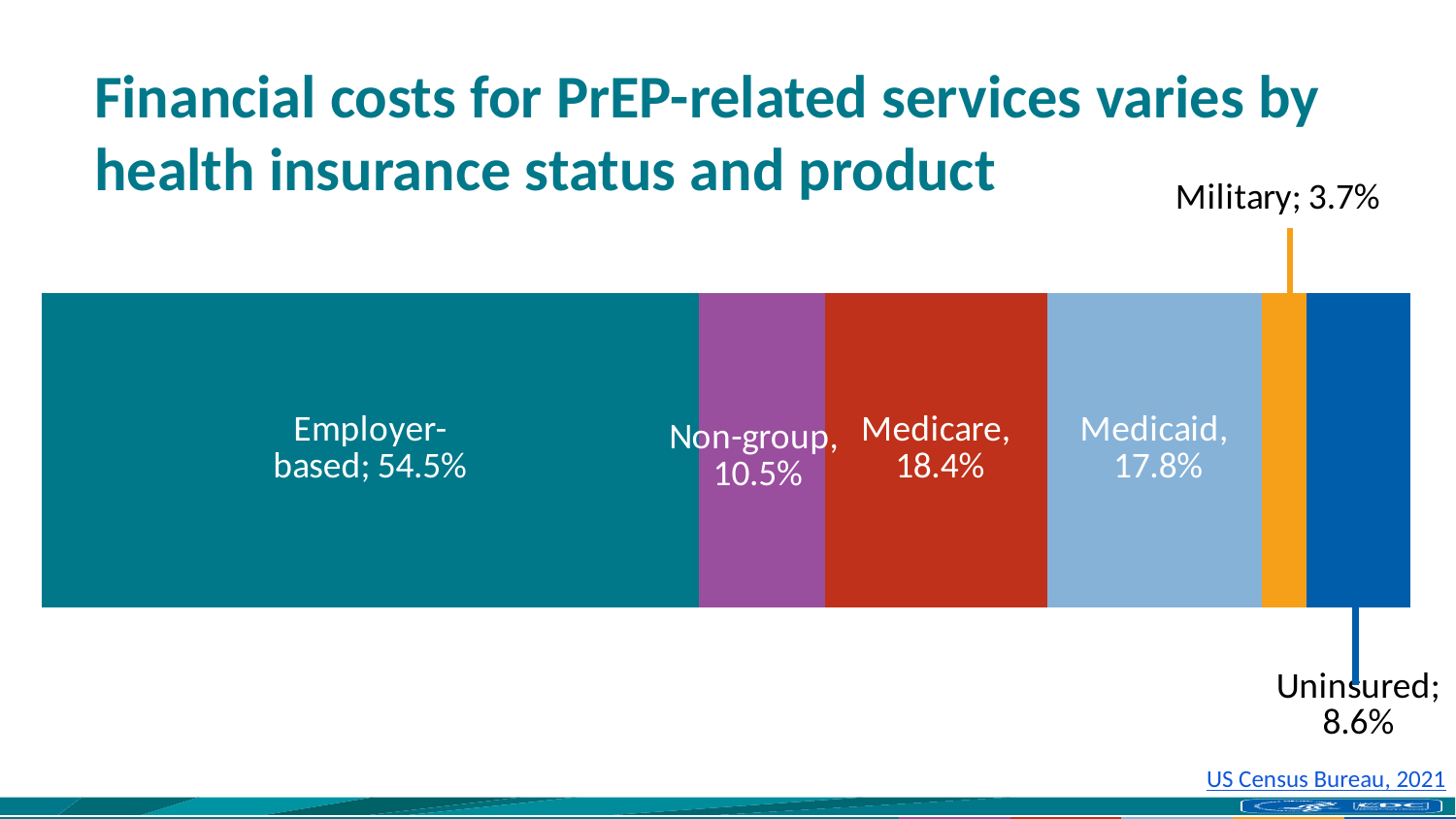
What is the value for Military? 3.7% What is the value for Medicare? 18.4% What colour is the Military segment of the bar? Orange What kind of chart is shown on the slide? Stacked bar chart Which is larger, the value for Uninsured or the value for Non-group? Non-group What is the difference between the Employer-based and Non-group values? 44.0% Which category has the highest value? Employer-based What is the value for Medicaid? 17.8% What is the value for Uninsured? 8.6% How many categories (segments) are shown in the bar? 6 What is the value for Employer-based? 54.5% Which category has the lowest value? Military